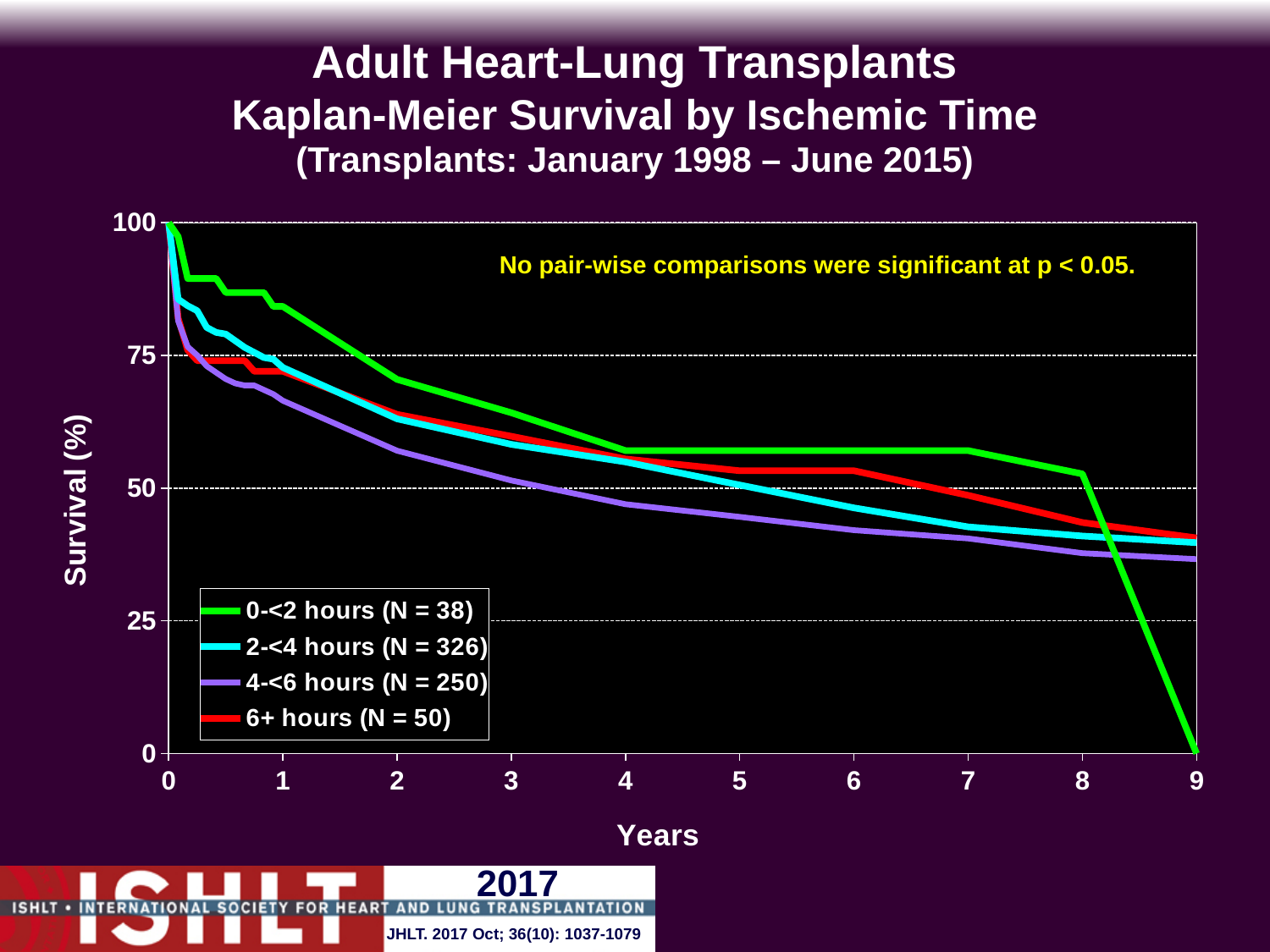
What is the N for the 2-<4 hours group shown in the legend? 326 How many series does the legend list? 4 Which group has the lowest survival at year 4? 4-<6 hours Is the survival value for the 2-<4 hours group at year 2 greater or less than 75? less Is the survival value for the 4-<6 hours group at year 6 greater or less than 50? less What is the survival value for the 0-<2 hours group at year 0? 100 Do the survival curves rise or fall as years increase? Fall What is the survival value for the 0-<2 hours group at year 9? 0 What kind of chart is shown on the slide? Line chart At year 4, which group has higher survival: 0-<2 hours or 4-<6 hours? 0-<2 hours Which group has the highest survival at year 2? 0-<2 hours Is the survival value for the 0-<2 hours group at year 4 greater or less than 50? greater